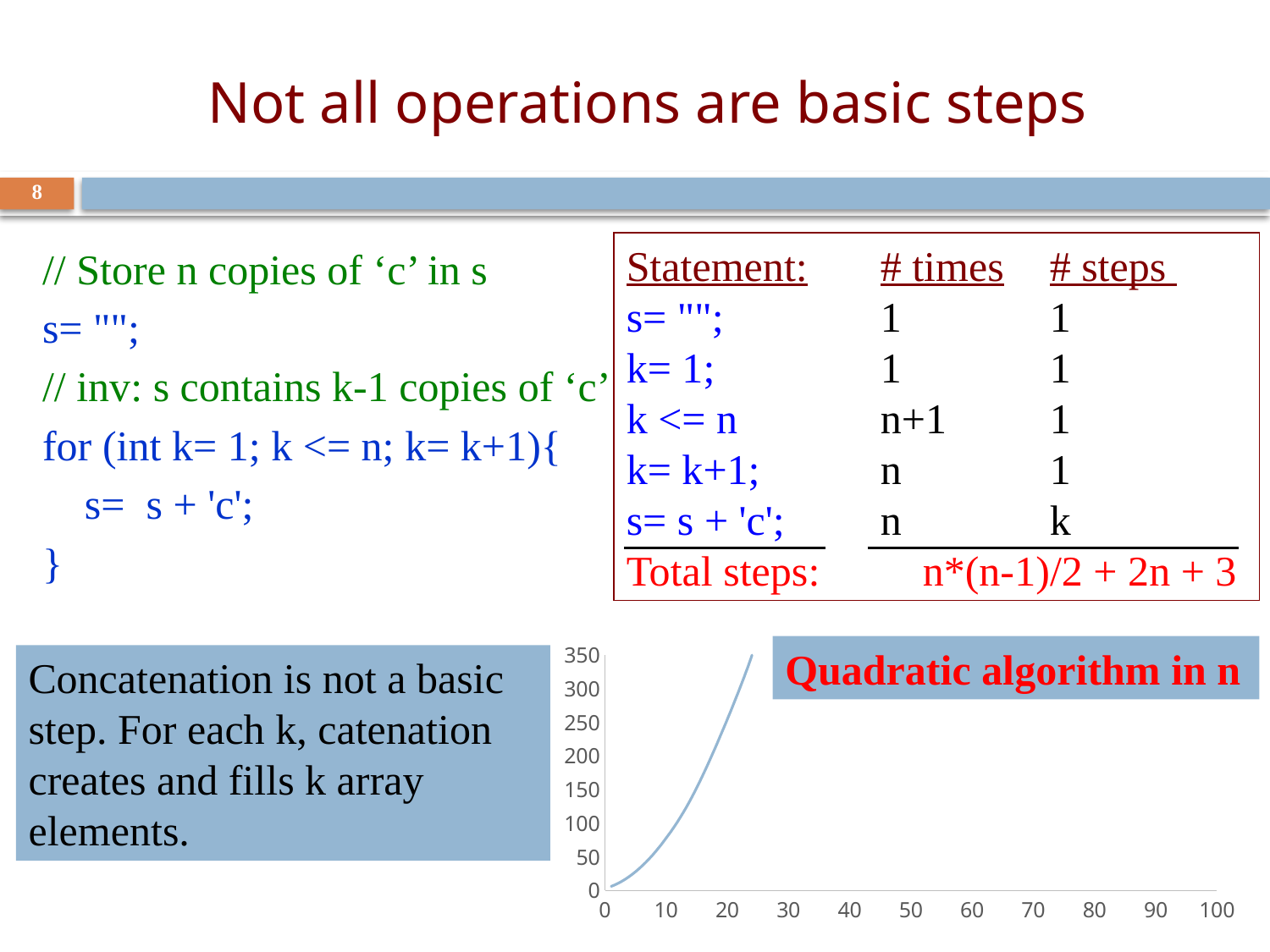
What is the highest tick value shown on the chart's x-axis? 100 Is the value of the plotted line at x = 20 greater or less than 150? greater What kind of chart is shown at the bottom of the slide? line chart What is the highest tick value shown on the chart's y-axis? 350 Is the value of the plotted line at x = 10 greater or less than 150? less Is the value of the plotted line at x = 20 greater or less than 300? less Which is larger on the chart: the plotted value at x = 10 or at x = 20? x = 20 Does the plotted line rise or fall as the x-axis value increases? rises